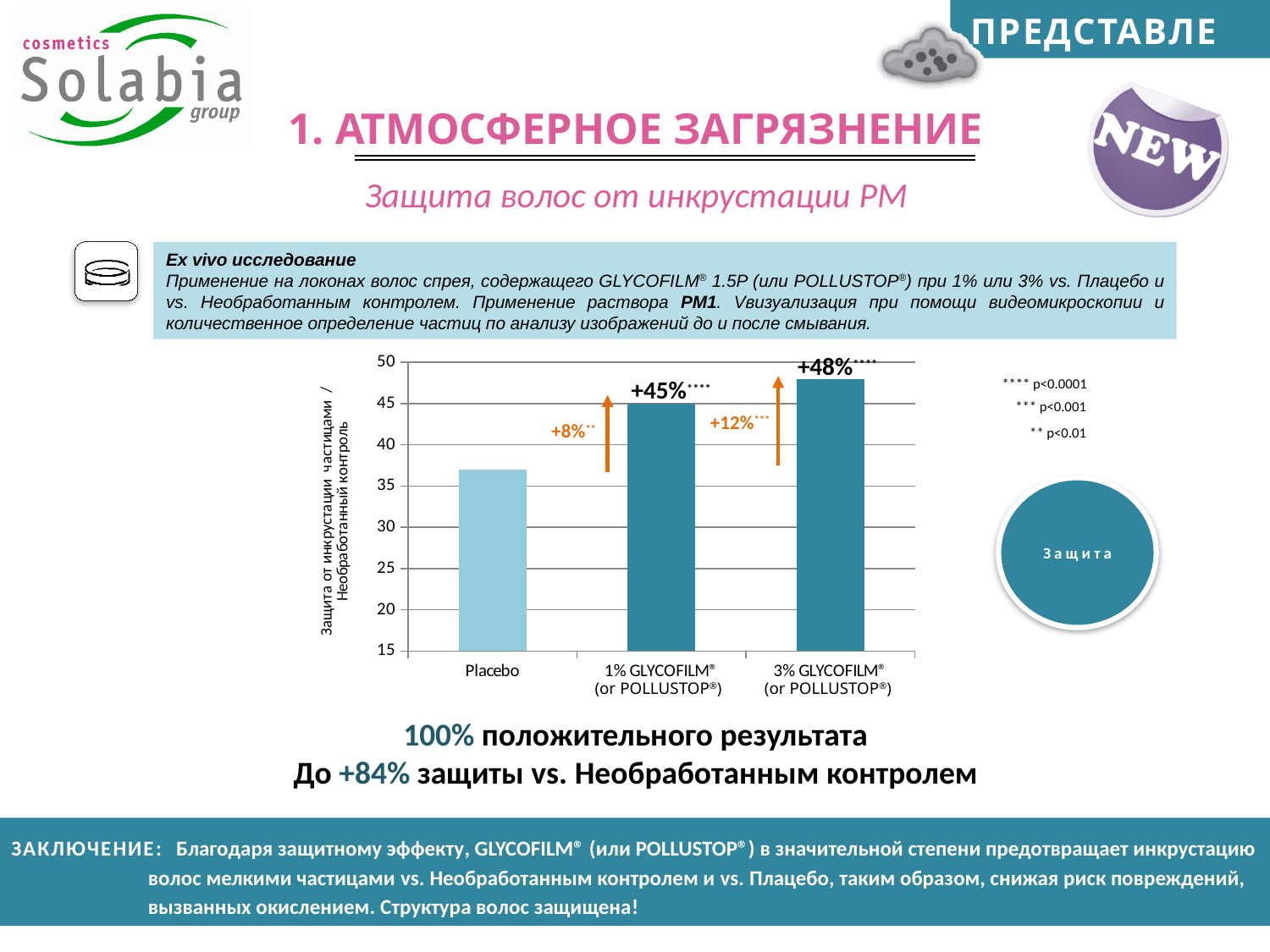
Do the bar values rise or fall from Placebo to 3% GLYCOFILM® along the x axis? rise Which bar is taller: 1% GLYCOFILM® or 3% GLYCOFILM®? 3% GLYCOFILM® What value is labelled on the bar for 3% GLYCOFILM® (or POLLUSTOP®)? +48% What is the highest tick value shown on the y axis of the chart? 50 What kind of chart is shown on the slide? bar chart What value is labelled on the bar for 1% GLYCOFILM® (or POLLUSTOP®)? +45% Is the value for Placebo greater or less than 40? less Which category has the lowest bar in the chart? Placebo Is the value for Placebo greater or less than 35? greater How many categories are shown on the x axis of the chart? 3 Which category has the highest bar in the chart? 3% GLYCOFILM® (or POLLUSTOP®) What percentage is written next to the arrow between the Placebo bar and the 1% GLYCOFILM® bar? +8%